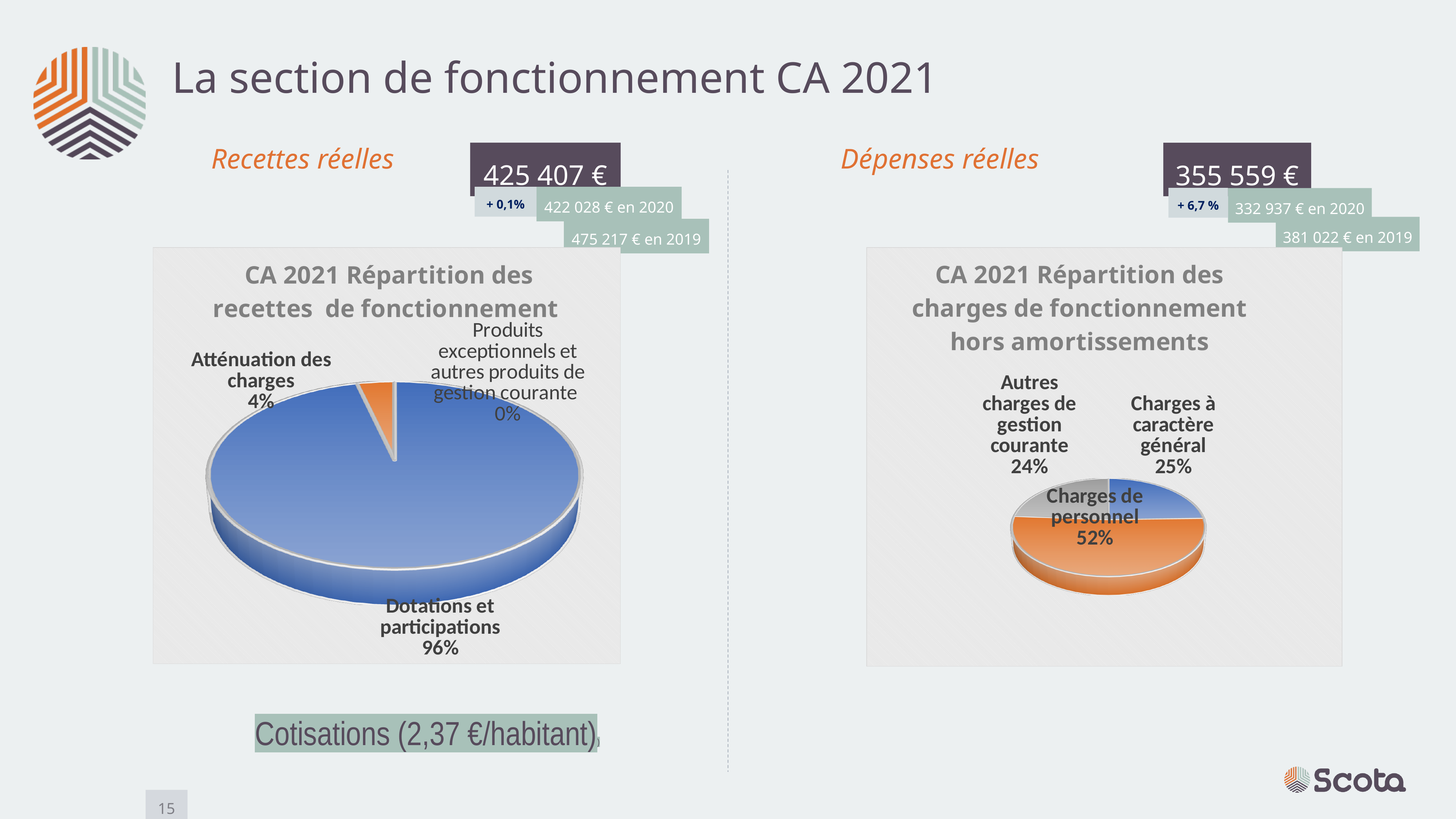
In the left chart 'CA 2021 Répartition des recettes de fonctionnement', which category has the largest slice? Dotations et participations In the right chart 'CA 2021 Répartition des charges de fonctionnement hors amortissements', what colour is the 'Charges de personnel' slice? Orange In the right chart 'CA 2021 Répartition des charges de fonctionnement hors amortissements', what is the difference in percentage points between 'Charges de personnel' and 'Charges à caractère général'? 27 In the right chart 'CA 2021 Répartition des charges de fonctionnement hors amortissements', which category has the largest slice? Charges de personnel In the right chart 'CA 2021 Répartition des charges de fonctionnement hors amortissements', what share does 'Charges de personnel' have? 52% In the right chart 'CA 2021 Répartition des charges de fonctionnement hors amortissements', what share does 'Autres charges de gestion courante' have? 24% In the right chart 'CA 2021 Répartition des charges de fonctionnement hors amortissements', what share does 'Charges à caractère général' have? 25% What kind of chart is the left chart 'CA 2021 Répartition des recettes de fonctionnement'? Pie chart In the left chart 'CA 2021 Répartition des recettes de fonctionnement', how many categories are labelled? 3